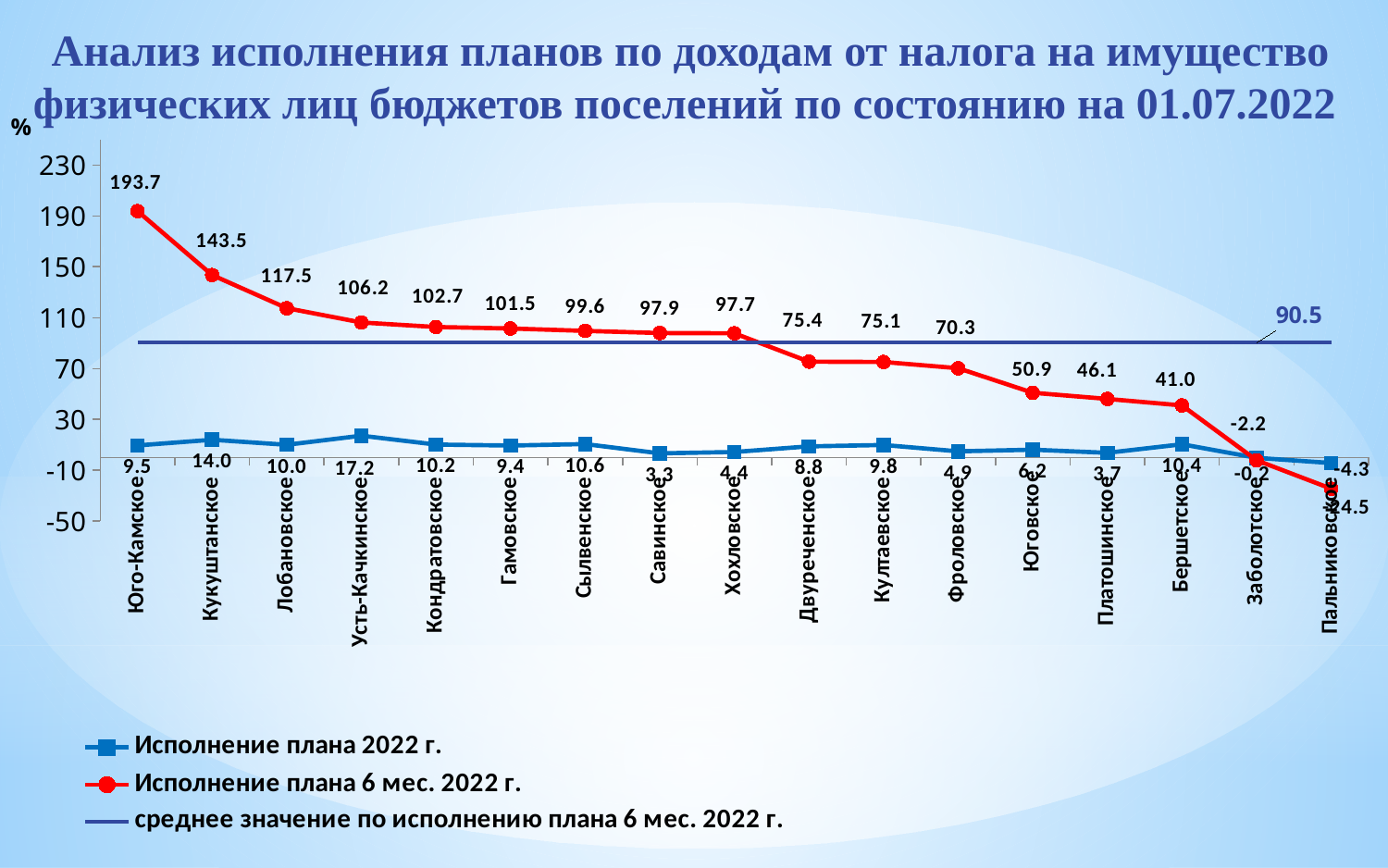
What is the difference between the 'Исполнение плана 6 мес. 2022 г.' values for Кукуштанское and Лобановское? 26.0 Which settlement has the highest value for 'Исполнение плана 2022 г.'? Усть-Качкинское What is the value of 'Исполнение плана 2022 г.' for Усть-Качкинское? 17.2 Which has a larger 'Исполнение плана 6 мес. 2022 г.' value, Фроловское or Юговское? Фроловское What kind of chart is shown on the slide? line chart What is the value shown for the average line 'среднее значение по исполнению плана 6 мес. 2022 г.'? 90.5 Which settlement has the highest value for 'Исполнение плана 6 мес. 2022 г.'? Юго-Камское What is the difference between the 'Исполнение плана 2022 г.' values for Кукуштанское and Юго-Камское? 4.5 What is the value of 'Исполнение плана 6 мес. 2022 г.' for Юго-Камское? 193.7 How many settlements are shown on the x axis? 17 Does the 'Исполнение плана 6 мес. 2022 г.' series rise or fall from left to right along the x axis? fall How many entries does the legend list? 3